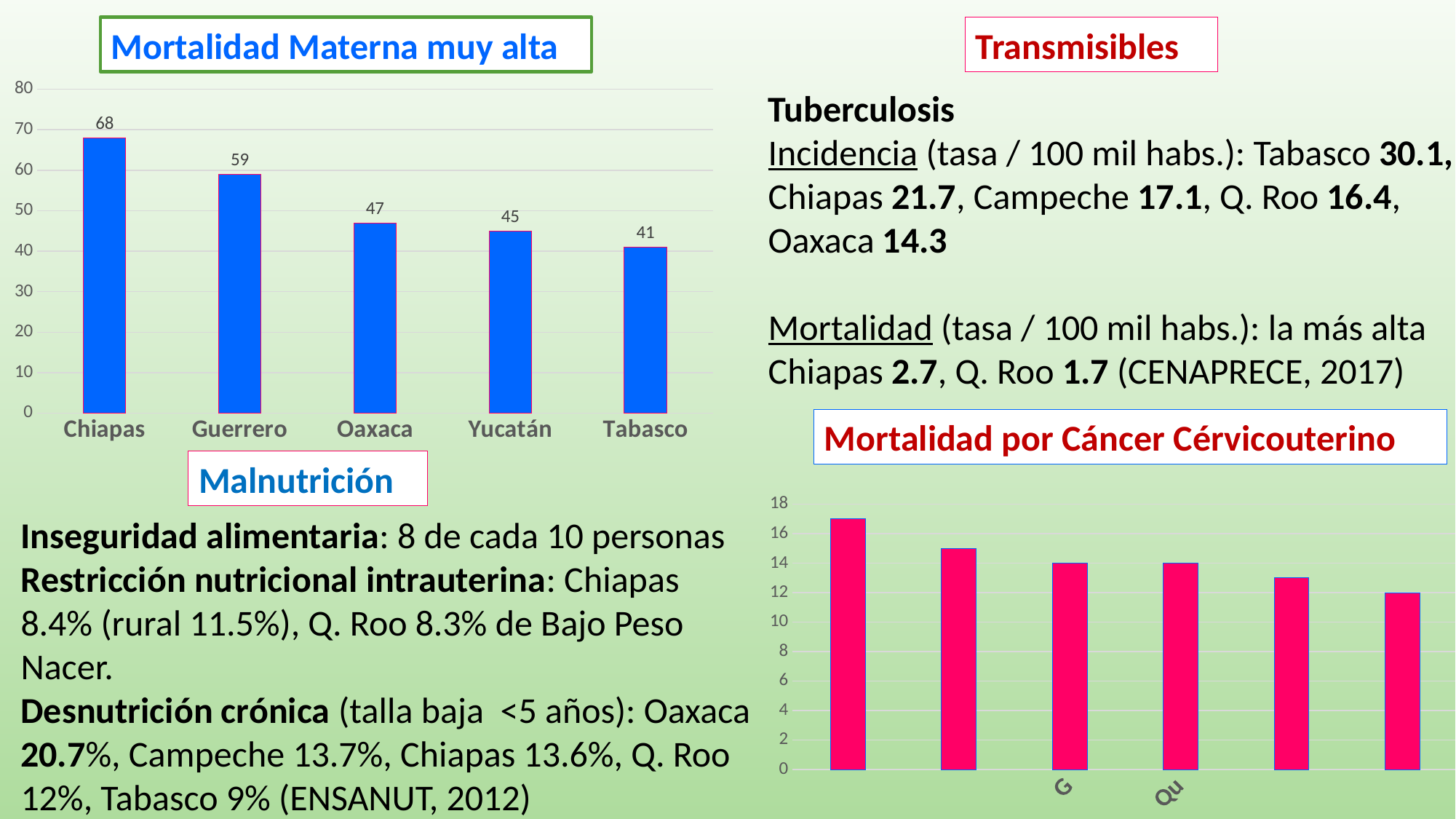
In the 'Mortalidad Materna muy alta' chart, what is the value for Tabasco? 41 In the 'Mortalidad Materna muy alta' chart, what is the value for Guerrero? 59 In the 'Mortalidad Materna muy alta' chart, which state has the highest value? Chiapas Do the values in the 'Mortalidad Materna muy alta' chart rise or fall from left to right? fall In the 'Mortalidad por Cáncer Cérvicouterino' chart, is the value of the leftmost bar greater or less than 16? greater In the 'Mortalidad Materna muy alta' chart, what is the difference between the values for Chiapas and Guerrero? 9 What kind of chart is the 'Mortalidad por Cáncer Cérvicouterino' chart? bar chart How many bars are shown in the 'Mortalidad por Cáncer Cérvicouterino' chart? 6 How many states are shown in the 'Mortalidad Materna muy alta' chart? 5 In the 'Mortalidad Materna muy alta' chart, what is the value for Chiapas? 68 In the 'Mortalidad Materna muy alta' chart, which is larger, the value for Oaxaca or the value for Yucatán? Oaxaca In the 'Mortalidad Materna muy alta' chart, which state has the lowest value? Tabasco